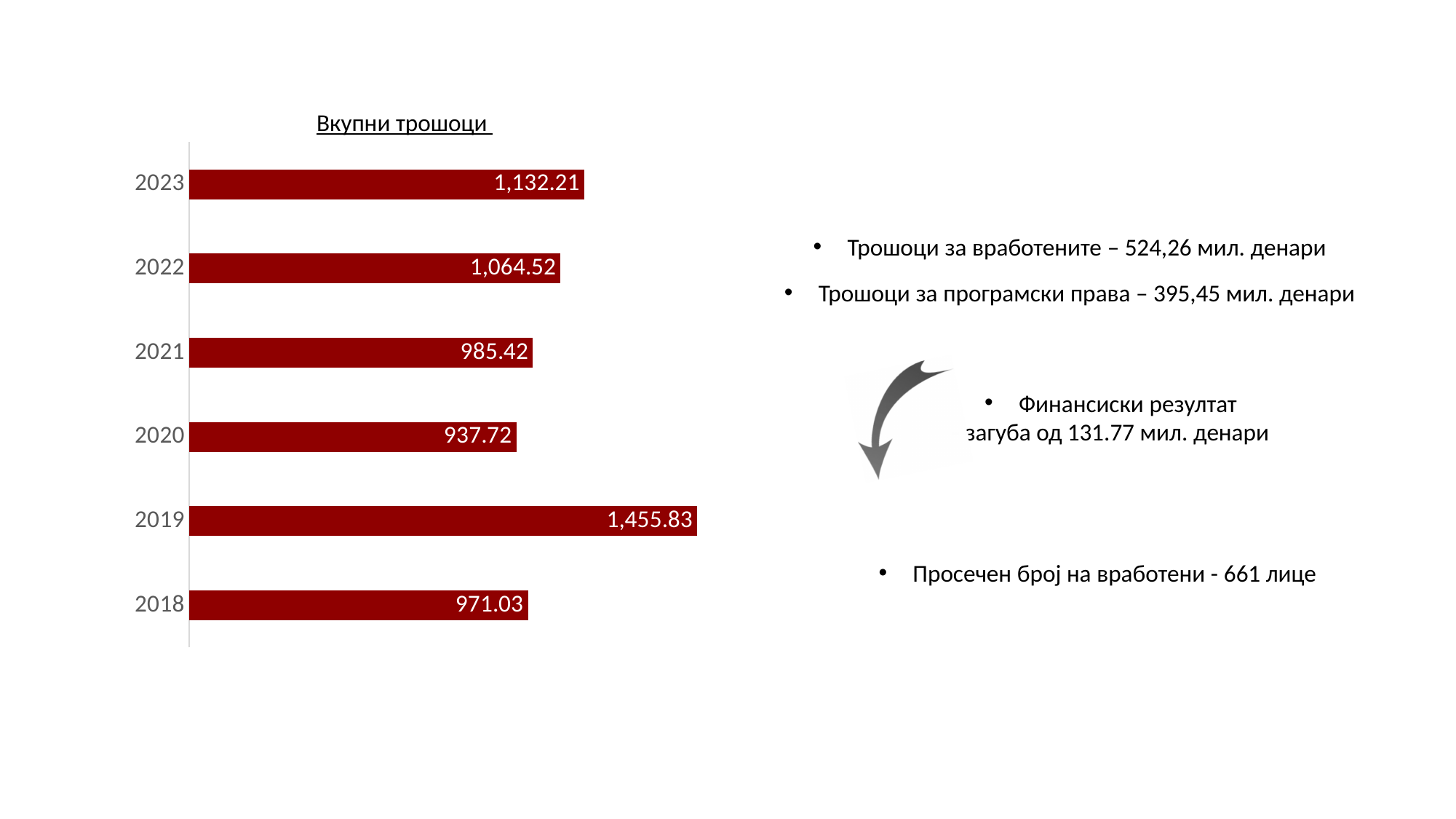
What is the value for 2023 in the Вкупни трошоци chart? 1,132.21 How many years are shown in the Вкупни трошоци chart? 6 What is the value for 2020 in the Вкупни трошоци chart? 937.72 What is the difference between the values for 2019 and 2018 in the Вкупни трошоци chart? 484.80 Which is larger in the Вкупни трошоци chart, the value for 2021 or the value for 2018? 2021 What is the difference between the values for 2023 and 2022 in the Вкупни трошоци chart? 67.69 What is the value for 2018 in the Вкупни трошоци chart? 971.03 What is the value for 2019 in the Вкупни трошоци chart? 1,455.83 Which year has the lowest value in the Вкупни трошоци chart? 2020 What kind of chart is the Вкупни трошоци chart? Bar chart Which year has the highest value in the Вкупни трошоци chart? 2019 Do the values in the Вкупни трошоци chart rise or fall from 2020 to 2023? Rise